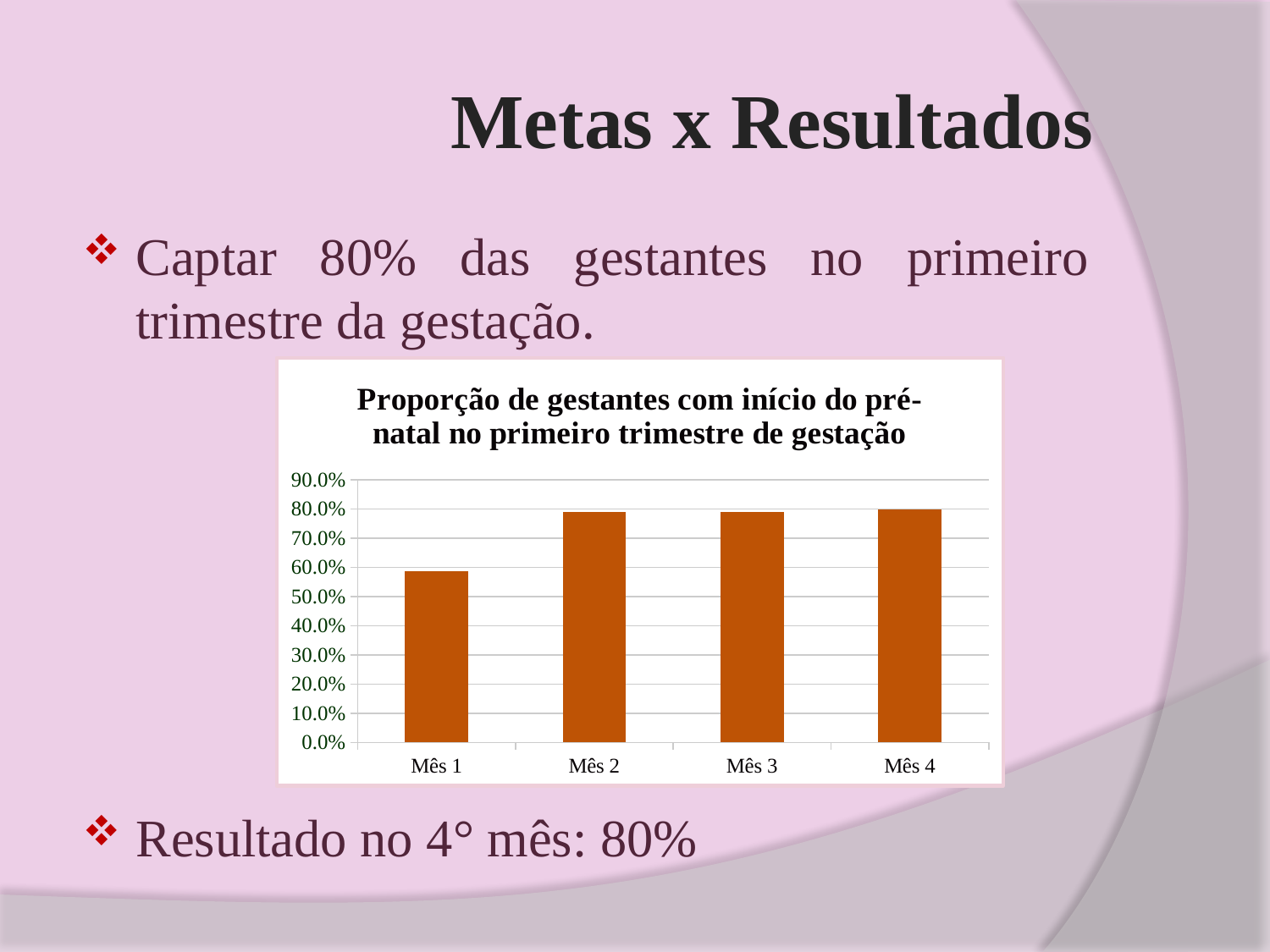
Is the value for Mês 1 greater or less than 60.0%? less Which month has the lowest proportion on the chart? Mês 1 Is the value for Mês 2 greater or less than 70.0%? greater What is the title of the chart? Proporção de gestantes com início do pré-natal no primeiro trimestre de gestação What kind of chart is shown on the slide? bar chart What is the highest value shown on the chart's vertical axis? 90.0% What is the proportion shown for Mês 4? 80% Is the value for Mês 3 greater or less than 90.0%? less How many months (categories) are plotted on the chart? 4 Does the value rise or fall from Mês 1 to Mês 2? rise Which is larger, the value for Mês 1 or the value for Mês 2? Mês 2